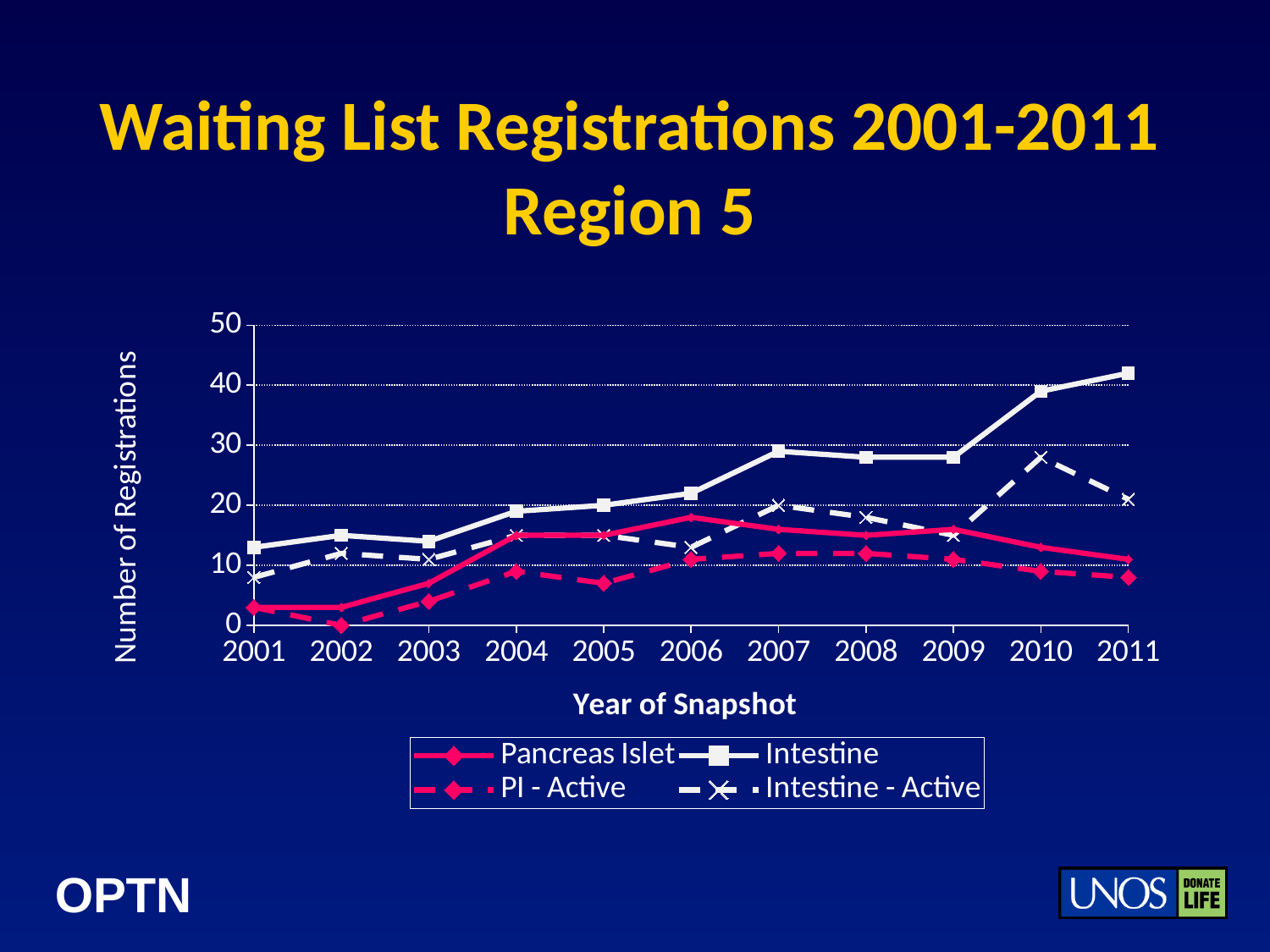
Is the value for Intestine in 2010 greater or less than 30? greater In which year is the Intestine series at its highest? 2011 Is the value for Intestine in 2011 greater or less than 30? greater In 2010, which is larger: Intestine or Pancreas Islet? Intestine What is the title of the chart on the slide? Waiting List Registrations 2001-2011 Region 5 How many series does the legend list? 4 In which year is the Intestine - Active series at its lowest? 2001 Is the value for Intestine - Active in 2010 greater or less than 20? greater How many years are plotted along the x axis? 11 What is the label of the x axis? Year of Snapshot What kind of chart is shown on the slide? Line chart